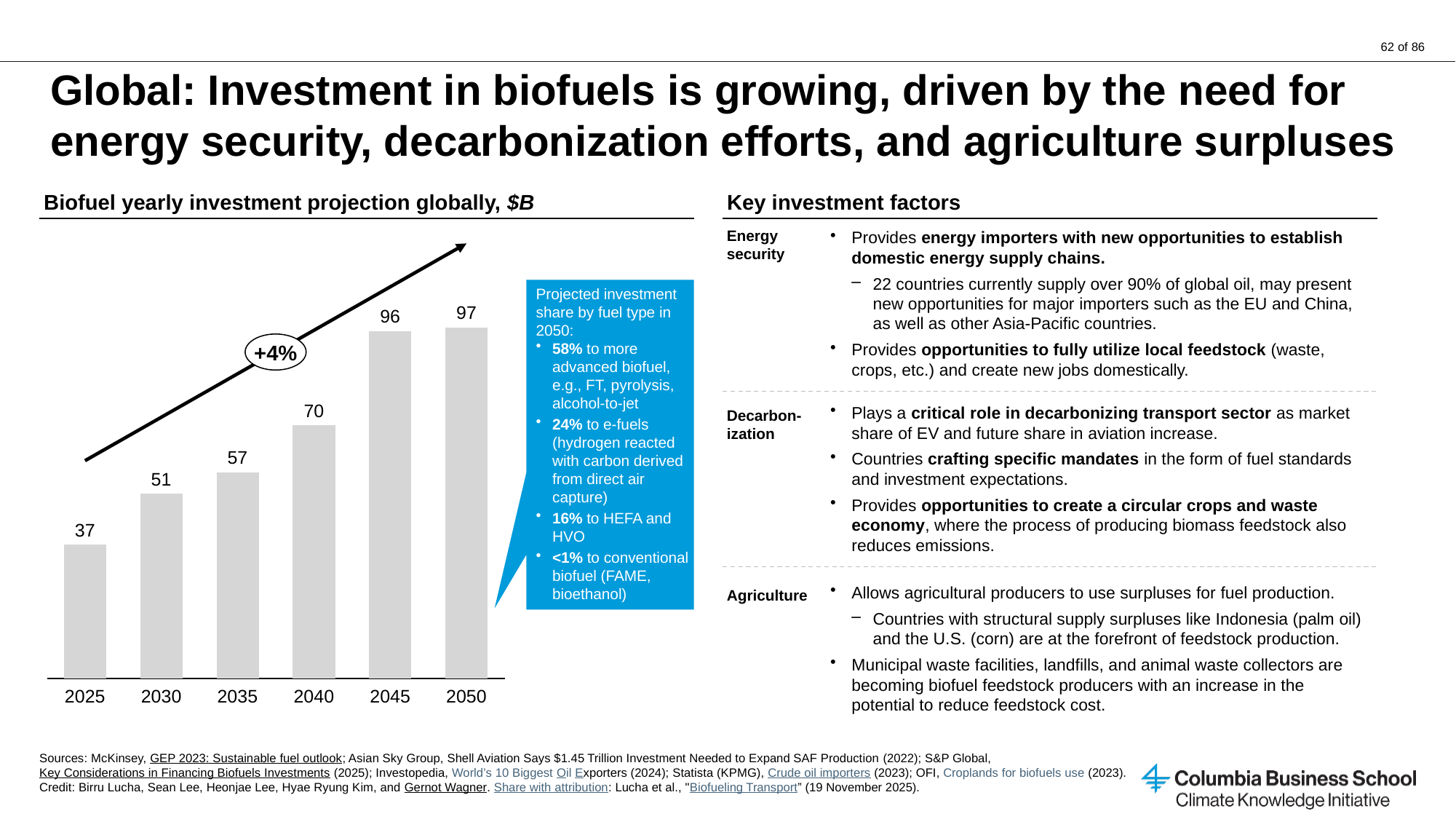
What kind of chart is used to show the biofuel yearly investment projection? Bar chart Which year has the lowest projected biofuel investment? 2025 What is the difference between the projected investment in 2050 and in 2025? 60 Do the projected investment values rise or fall from 2025 to 2050? Rise What is the projected biofuel yearly investment for 2025? 37 What is the projected biofuel yearly investment for 2040? 70 Which year has the highest projected biofuel investment? 2050 What is the projected biofuel yearly investment for 2050? 97 What is the difference between the projected investment in 2040 and in 2035? 13 How many years are shown on the x axis of the chart? 6 What annual growth rate is labelled on the arrow above the bars? +4% Which is larger, the projected investment in 2030 or in 2035? 2035